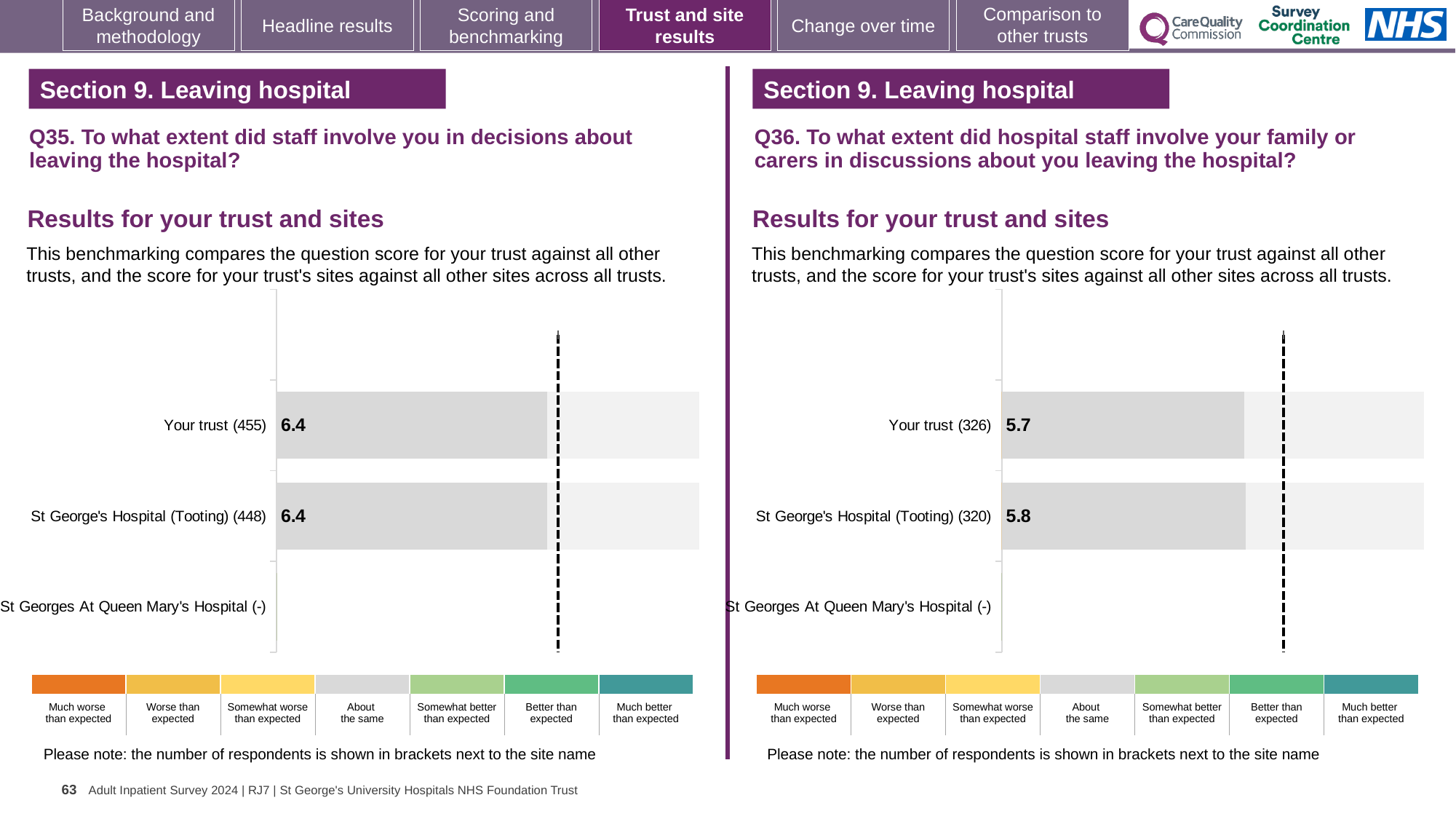
In the Q36 chart on the right, what is the score for St George's Hospital (Tooting)? 5.8 In the Q36 chart on the right, what is the difference between the score for St George's Hospital (Tooting) and the score for Your trust? 0.1 What kind of chart is used for the Q36 results on the right? Bar chart How many sites or trusts are listed on the y axis of the Q35 chart on the left? 3 In the Q36 chart on the right, which site or trust has the highest score? St George's Hospital (Tooting) In the Q36 chart on the right, what is the score for Your trust? 5.7 In the Q36 chart on the right, how many respondents are shown in brackets for St George's Hospital (Tooting)? 320 How many benchmark categories does the colour legend below the Q35 chart on the left show? 7 In the Q35 chart on the left, how many respondents are shown in brackets for Your trust? 455 In the Q35 chart on the left, what is the score for Your trust? 6.4 In the Q35 chart on the left, what is the score for St George's Hospital (Tooting)? 6.4 In the Q36 chart on the right, which is larger: the score for Your trust or the score for St George's Hospital (Tooting)? St George's Hospital (Tooting)